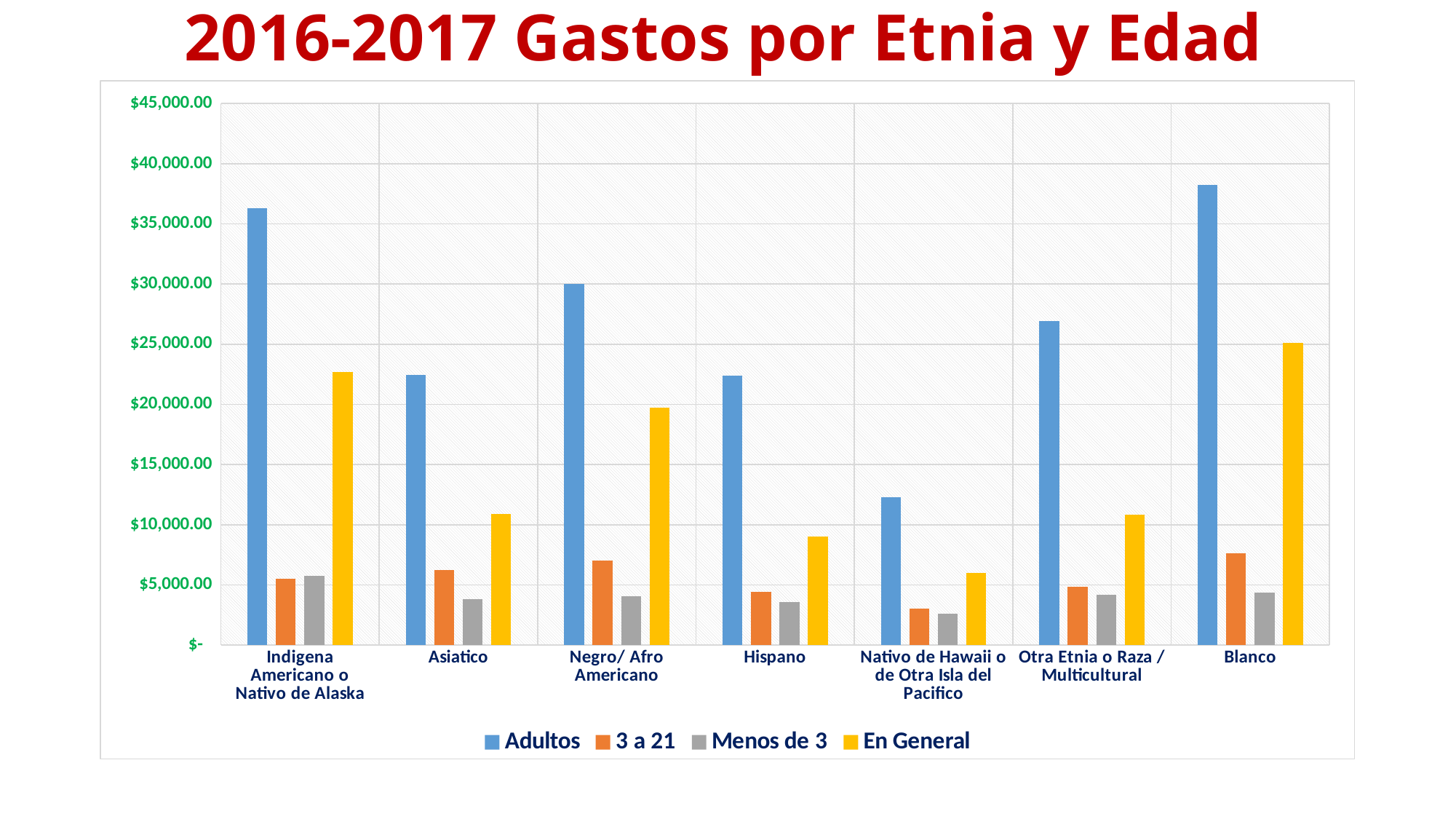
Is the Adultos value for Indigena Americano o Nativo de Alaska greater or less than $35,000.00? greater Which category has the highest Adultos value? Blanco What kind of chart is shown on the slide? bar chart What is the title of the slide? 2016-2017 Gastos por Etnia y Edad Which category has the highest En General value? Blanco Which category has the lowest En General value? Nativo de Hawaii o de Otra Isla del Pacifico How many ethnic categories are shown along the x axis? 7 Which is larger, the Adultos value for Indigena Americano o Nativo de Alaska or for Negro/ Afro Americano? Indigena Americano o Nativo de Alaska How many series does the legend list? 4 Which category has the lowest Adultos value? Nativo de Hawaii o de Otra Isla del Pacifico Is the Adultos value for Otra Etnia o Raza / Multicultural greater or less than $25,000.00? greater Is the En General value for Hispano greater or less than $10,000.00? less